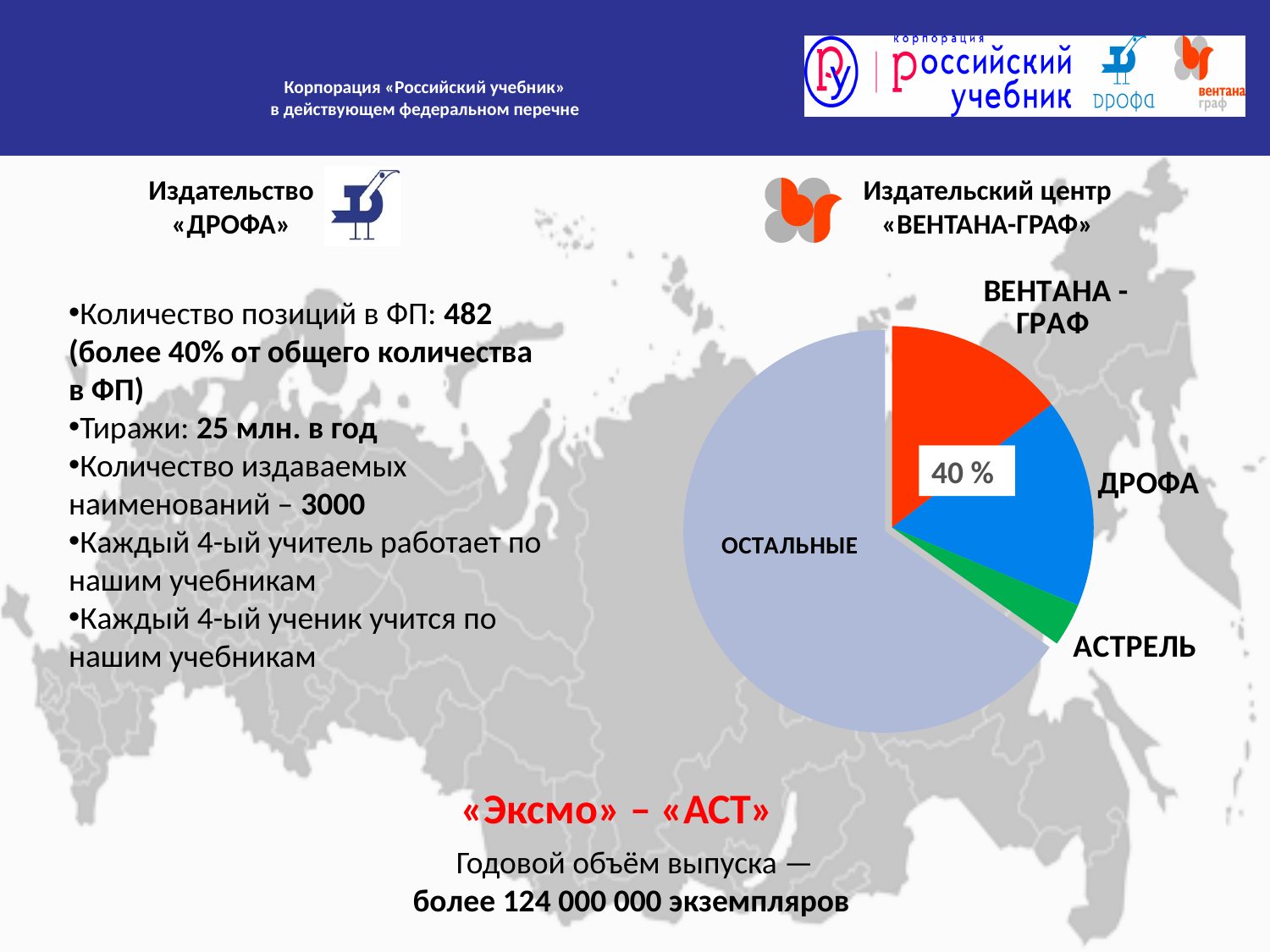
Which slice is larger in the pie chart, ДРОФА or АСТРЕЛЬ? ДРОФА What kind of chart is shown on the slide? pie chart Which slice is larger in the pie chart, ВЕНТАНА-ГРАФ or АСТРЕЛЬ? ВЕНТАНА-ГРАФ Which slice is larger in the pie chart, ОСТАЛЬНЫЕ or ВЕНТАНА-ГРАФ? ОСТАЛЬНЫЕ Which slice of the pie chart is the largest? ОСТАЛЬНЫЕ Which slice of the pie chart is the smallest? АСТРЕЛЬ How many slices does the pie chart have? 4 What percentage label is printed on the pie chart? 40 % What colour is the ОСТАЛЬНЫЕ slice of the pie chart? light blue